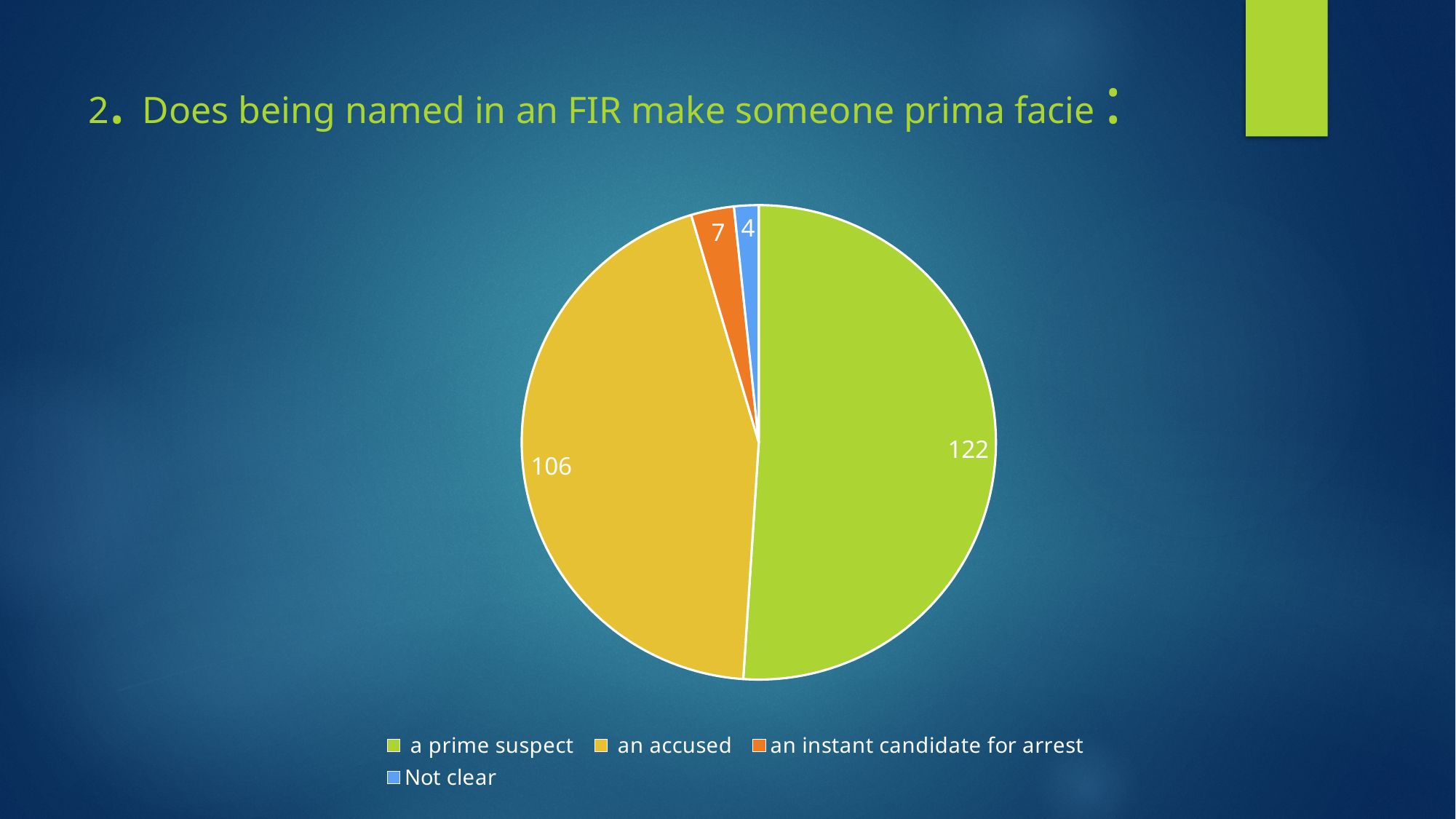
What colour is the slice for 'an accused'? yellow Which category has the smallest slice of the pie? Not clear What is the value for 'an instant candidate for arrest'? 7 What is the value for 'a prime suspect'? 122 What is the total of all the values in the pie chart? 239 What is the difference between the values for 'a prime suspect' and 'an accused'? 16 What is the value for 'an accused'? 106 Which is larger, the value for 'an instant candidate for arrest' or the value for 'Not clear'? an instant candidate for arrest How many categories does the pie chart have? 4 What is the value for 'Not clear'? 4 What kind of chart is shown on the slide? pie chart Which category has the largest slice of the pie? a prime suspect